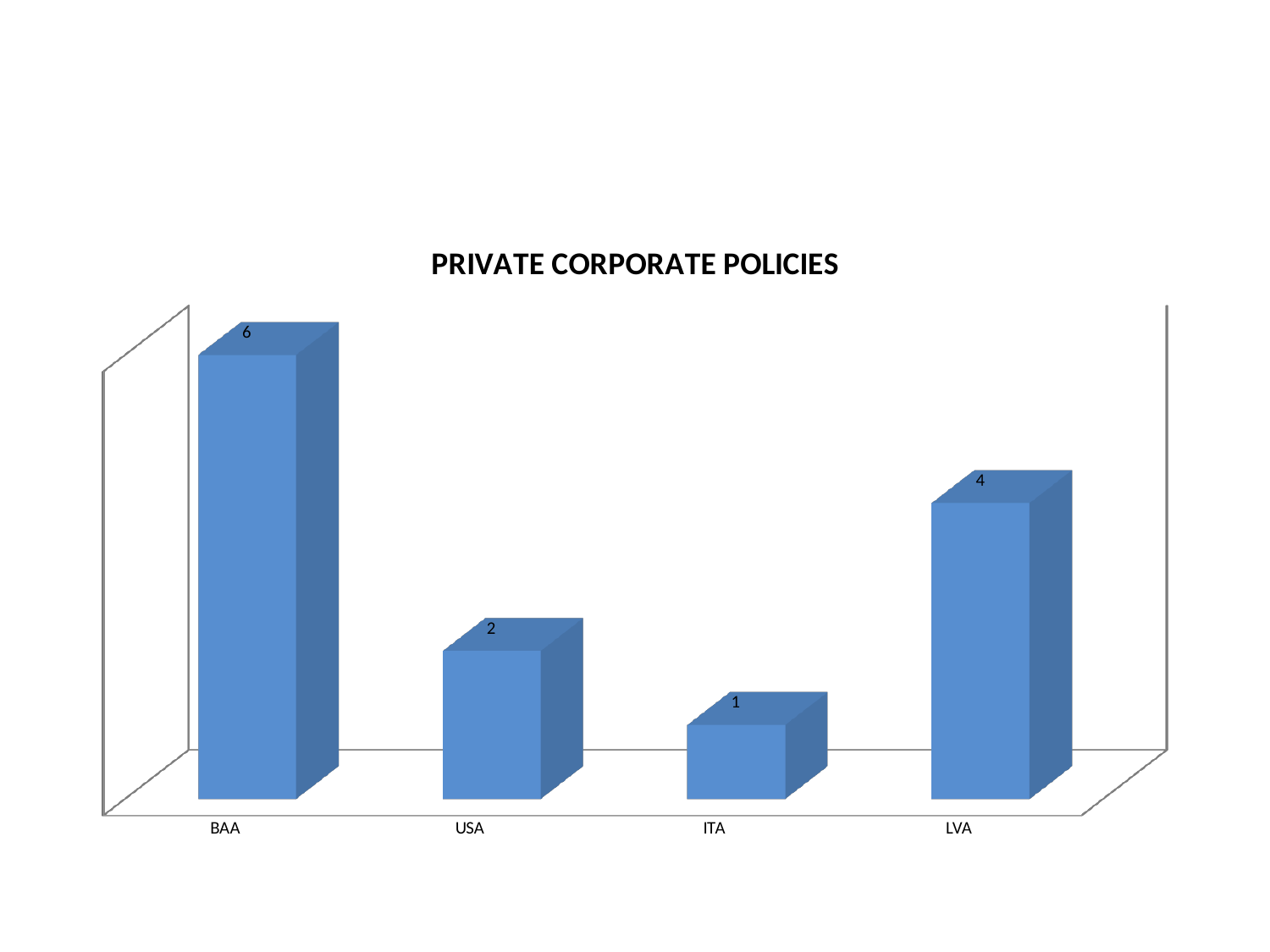
What is the difference between the values for USA and ITA? 1 How many categories are shown in the chart? 4 What is the value for USA? 2 Which is larger, the value for LVA or the value for USA? LVA What is the value for ITA? 1 What is the difference between the values for BAA and LVA? 2 What is the title of the chart? PRIVATE CORPORATE POLICIES What is the value for BAA? 6 Which category has the highest value? BAA What is the value for LVA? 4 What kind of chart is this? Bar chart Which category has the lowest value? ITA